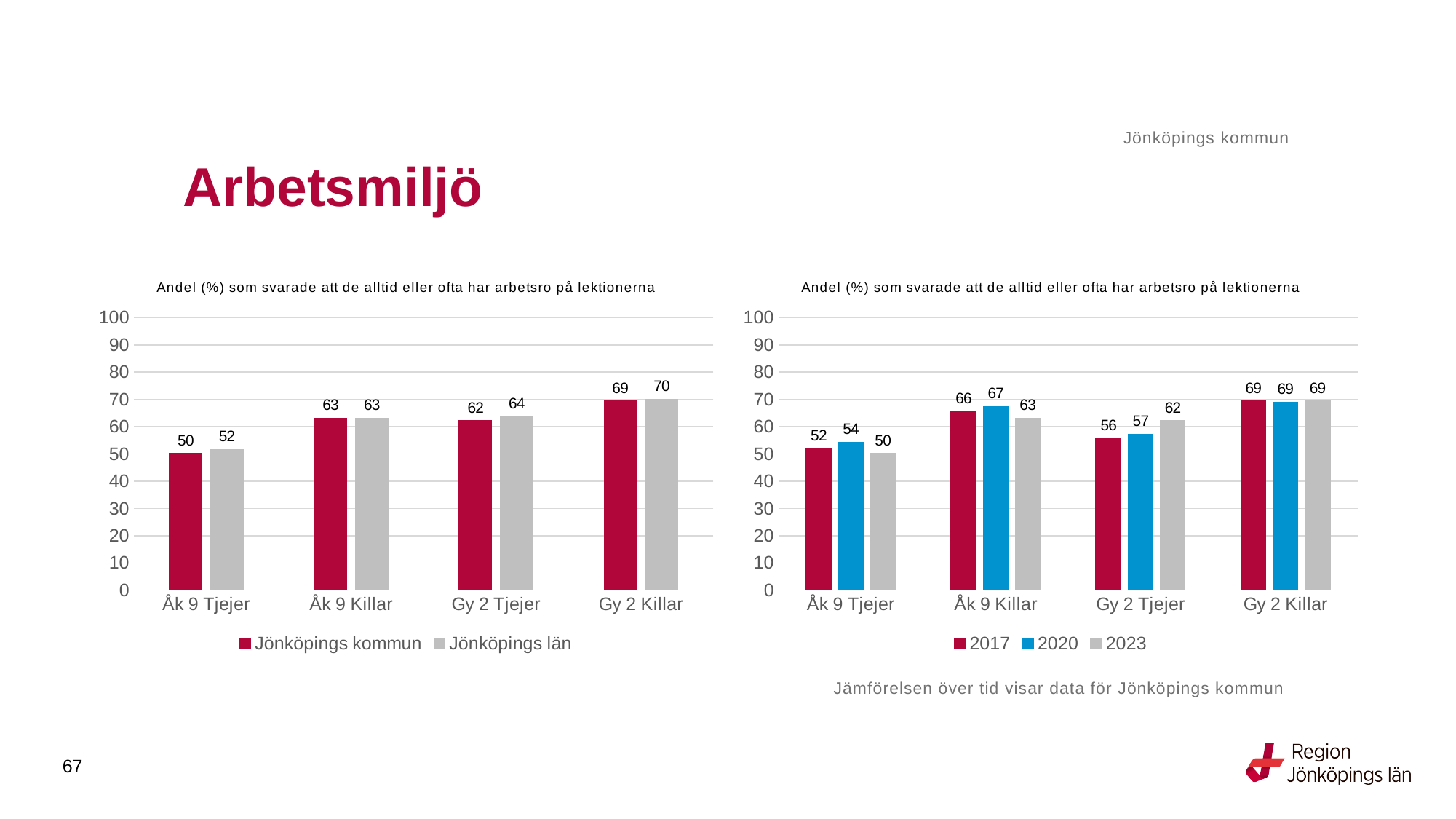
In the right chart, is the 2020 value for Åk 9 Tjejer larger or smaller than the 2023 value for Åk 9 Tjejer? larger What kind of chart is the right chart? bar chart In the right chart, what is the value for 2020 for Åk 9 Killar? 67 In the left chart, how many series does the legend list? 2 In the right chart, what is the value for 2023 for Åk 9 Tjejer? 50 In the left chart, what is the value for Jönköpings län for Gy 2 Killar? 70 In the left chart, what is the difference between Jönköpings län and Jönköpings kommun for Gy 2 Tjejer? 2 In the left chart, which category has the lowest value for Jönköpings kommun? Åk 9 Tjejer In the right chart, what is the difference between 2023 and 2017 for Gy 2 Tjejer? 6 In the left chart, what is the value for Jönköpings kommun for Åk 9 Tjejer? 50 In the right chart, which category has the highest value for 2017? Gy 2 Killar In the right chart, how many categories are shown on the x axis? 4